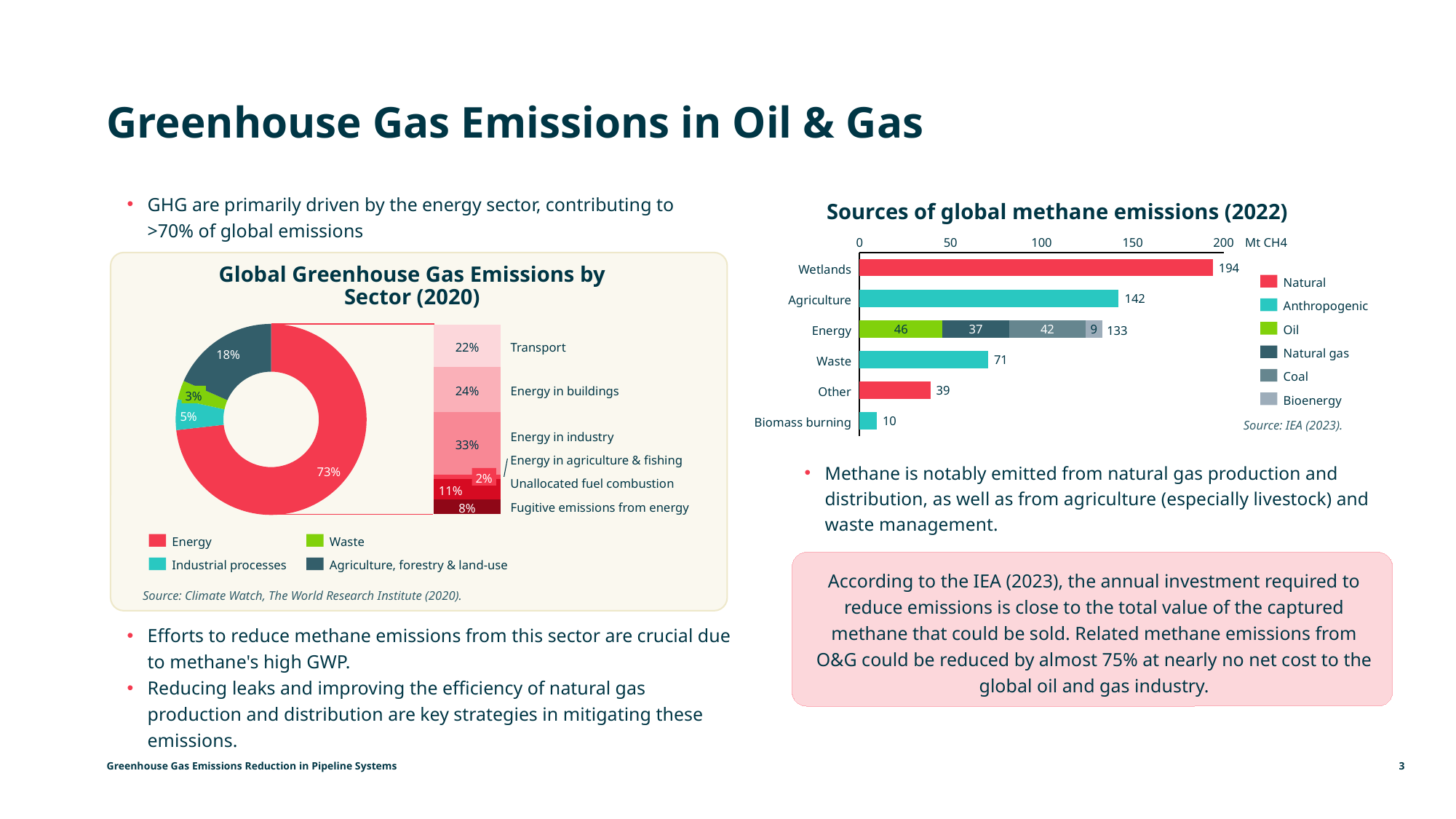
In the 'Sources of global methane emissions (2022)' chart, which is larger, Waste or Other? Waste In the 'Sources of global methane emissions (2022)' chart, what is the value for Wetlands? 194 In the 'Sources of global methane emissions (2022)' chart, which source has the lowest value? Biomass burning In the 'Sources of global methane emissions (2022)' chart, what is the Natural gas portion of the Energy bar? 37 In the 'Global Greenhouse Gas Emissions by Sector (2020)' chart, what share of emissions comes from Energy? 73% In the 'Global Greenhouse Gas Emissions by Sector (2020)' chart, how many sectors does the legend list? 4 In the 'Sources of global methane emissions (2022)' chart, how many sources are listed on the vertical axis? 6 What type of chart is 'Sources of global methane emissions (2022)'? Bar chart In the 'Sources of global methane emissions (2022)' chart, what is the difference between Agriculture and Energy? 9 In the 'Global Greenhouse Gas Emissions by Sector (2020)' chart, what share is attributed to Agriculture, forestry & land-use? 18% In the 'Global Greenhouse Gas Emissions by Sector (2020)' chart, what percentage of the Energy breakdown is Energy in industry? 33% In the 'Global Greenhouse Gas Emissions by Sector (2020)' chart, which sector has the smallest share? Waste